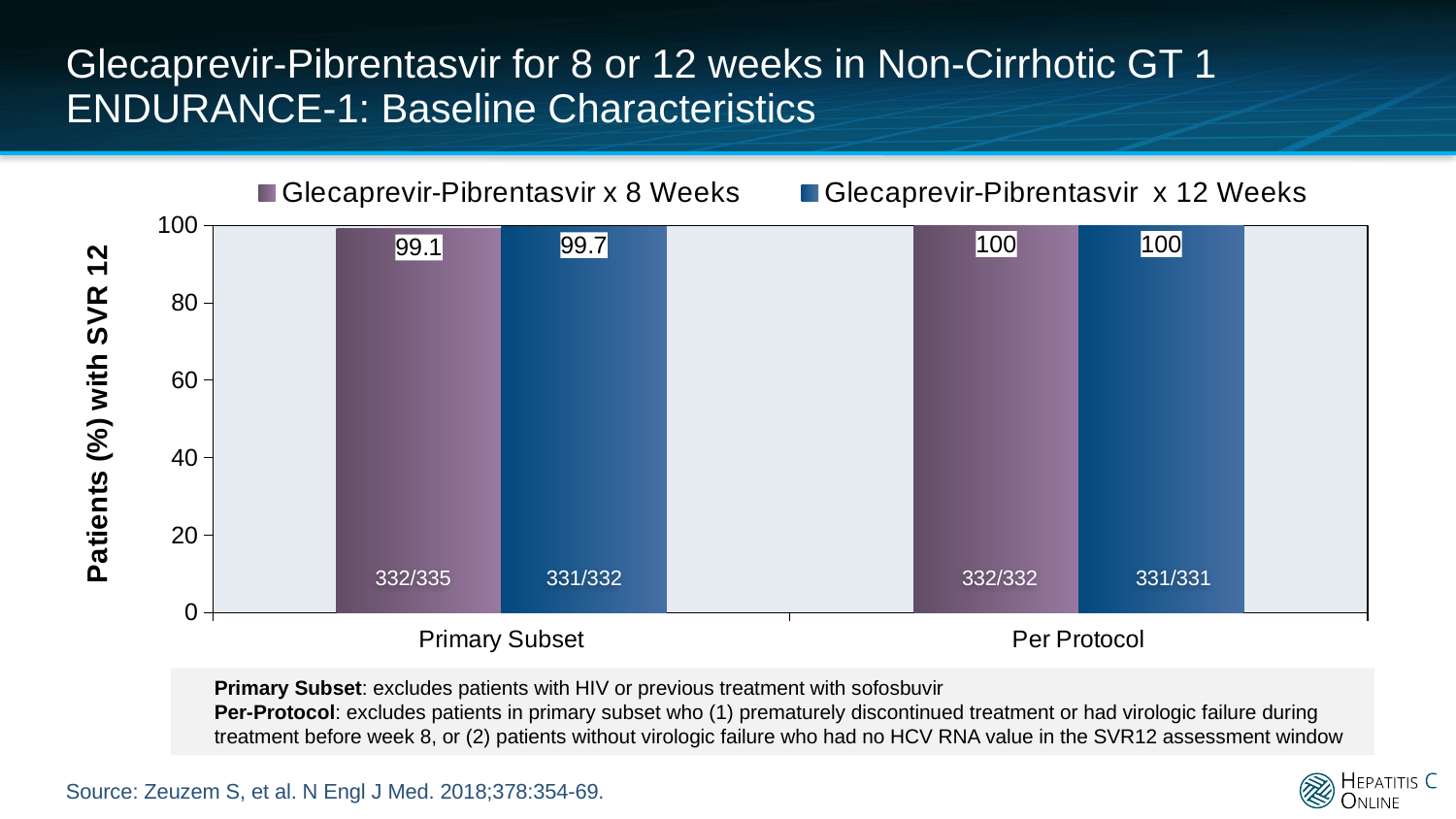
In the Primary Subset, which regimen has the higher SVR 12 rate, 8 weeks or 12 weeks? Glecaprevir-Pibrentasvir x 12 Weeks What is the SVR 12 rate for Glecaprevir-Pibrentasvir x 8 Weeks in the Per Protocol group? 100 What is the SVR 12 rate for Glecaprevir-Pibrentasvir x 12 Weeks in the Primary Subset? 99.7 How many series does the legend list? 2 What is the SVR 12 rate for Glecaprevir-Pibrentasvir x 8 Weeks in the Primary Subset? 99.1 What fraction of patients is shown for Glecaprevir-Pibrentasvir x 8 Weeks in the Per Protocol group? 332/332 How many categories are shown on the x axis? 2 What kind of chart is shown on the slide? Bar chart What is the label of the y axis? Patients (%) with SVR 12 What fraction of patients is shown for Glecaprevir-Pibrentasvir x 12 Weeks in the Primary Subset? 331/332 What is the difference between the 12-week and 8-week SVR 12 rates in the Primary Subset? 0.6 Is the value for Glecaprevir-Pibrentasvir x 8 Weeks in the Primary Subset greater or less than 80? greater